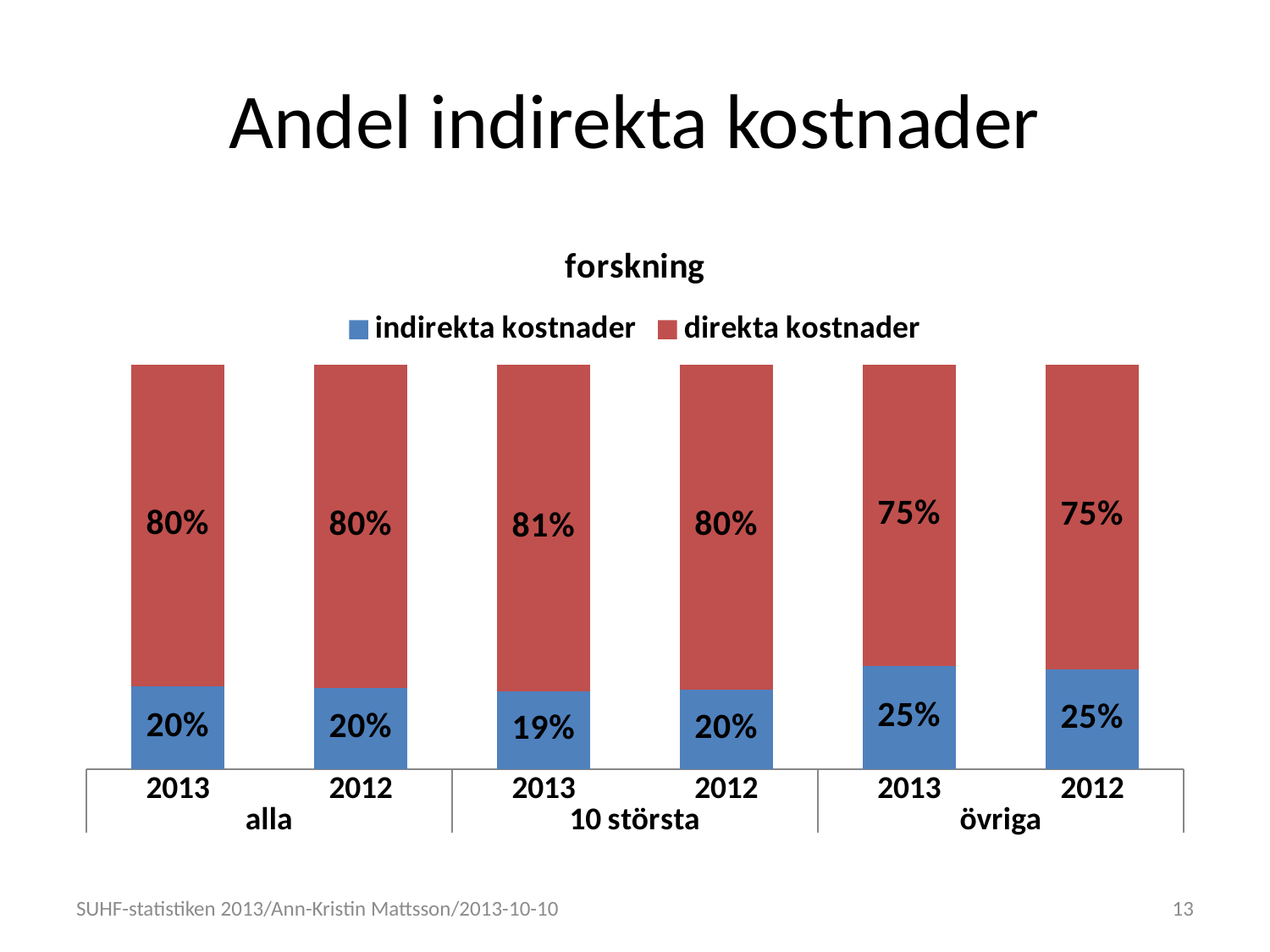
How many series does the legend list? 2 What is the value of indirekta kostnader for övriga in 2012? 25% What is the title of the chart? forskning Which group and year has the lowest share of indirekta kostnader? 10 största 2013 Which group and year has the highest share of indirekta kostnader? övriga (25% in both 2013 and 2012) Is the direkta kostnader share larger for alla 2013 or for övriga 2013? alla 2013 How many bars are shown in the chart? 6 What is the value of indirekta kostnader for alla in 2013? 20% What is the value of direkta kostnader for 10 största in 2013? 81% What kind of chart is shown on the slide? Stacked bar chart What is the value of indirekta kostnader for 10 största in 2013? 19% What is the difference between the indirekta kostnader share for övriga 2013 and 10 största 2013? 6 percentage points